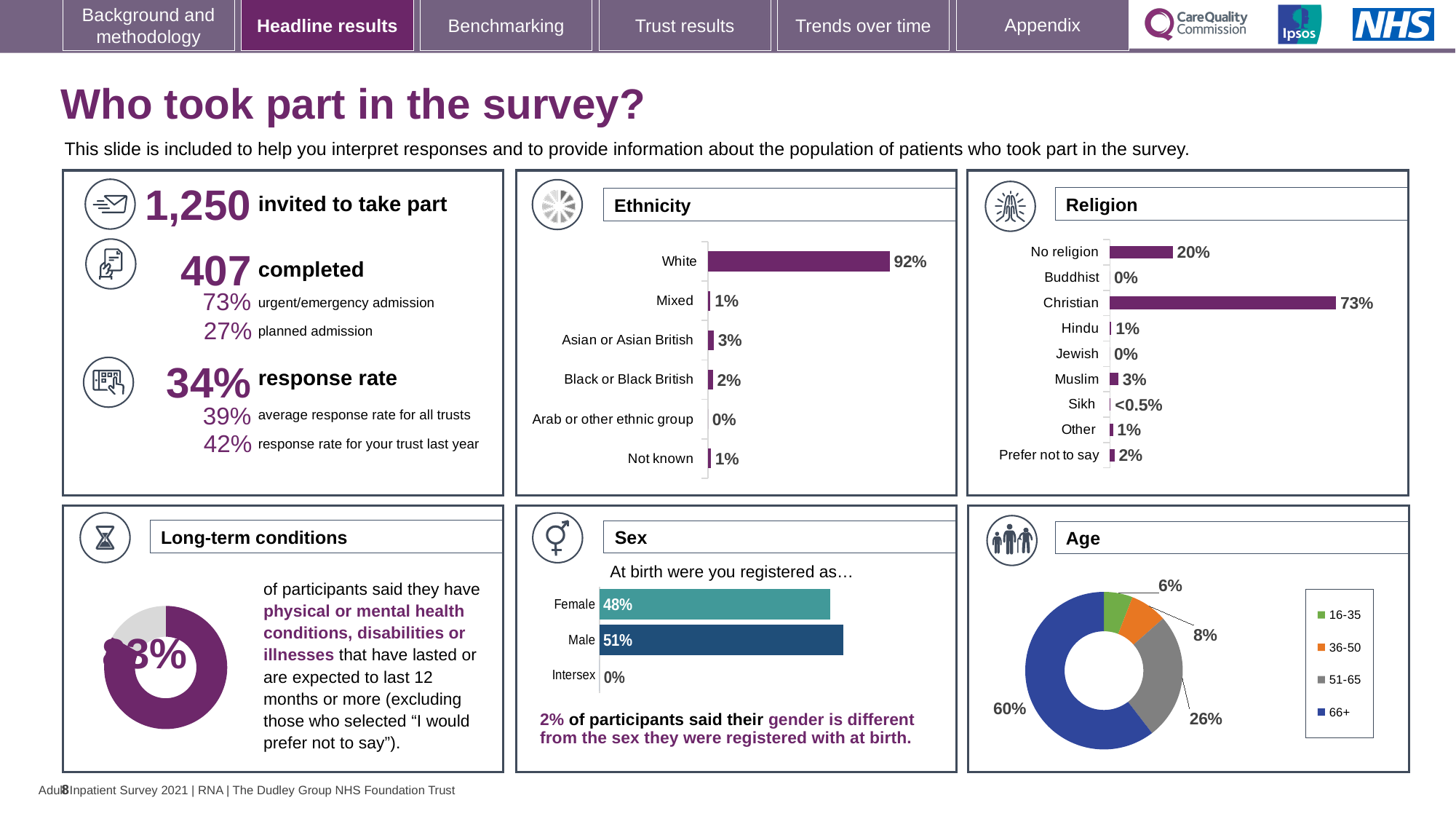
In the Ethnicity chart, what percentage of participants were White? 92% In the Sex chart, what is the difference between the Male and Female percentages? 3% In the Religion chart, what percentage of participants were Christian? 73% What type of chart is the Age chart? Doughnut chart In the Religion chart, which is larger, Muslim or Hindu? Muslim In the Religion chart, what is the value shown for Sikh? <0.5% In the Ethnicity chart, what is the value for Asian or Asian British? 3% In the Religion chart, what is the difference between the Christian and No religion percentages? 53% In the Age chart, what share of participants were aged 66+? 60% In the Sex chart, what percentage of participants were registered as Male at birth? 51% How many ethnic categories are shown in the Ethnicity chart? 6 In the Ethnicity chart, which ethnic group has the highest percentage? White